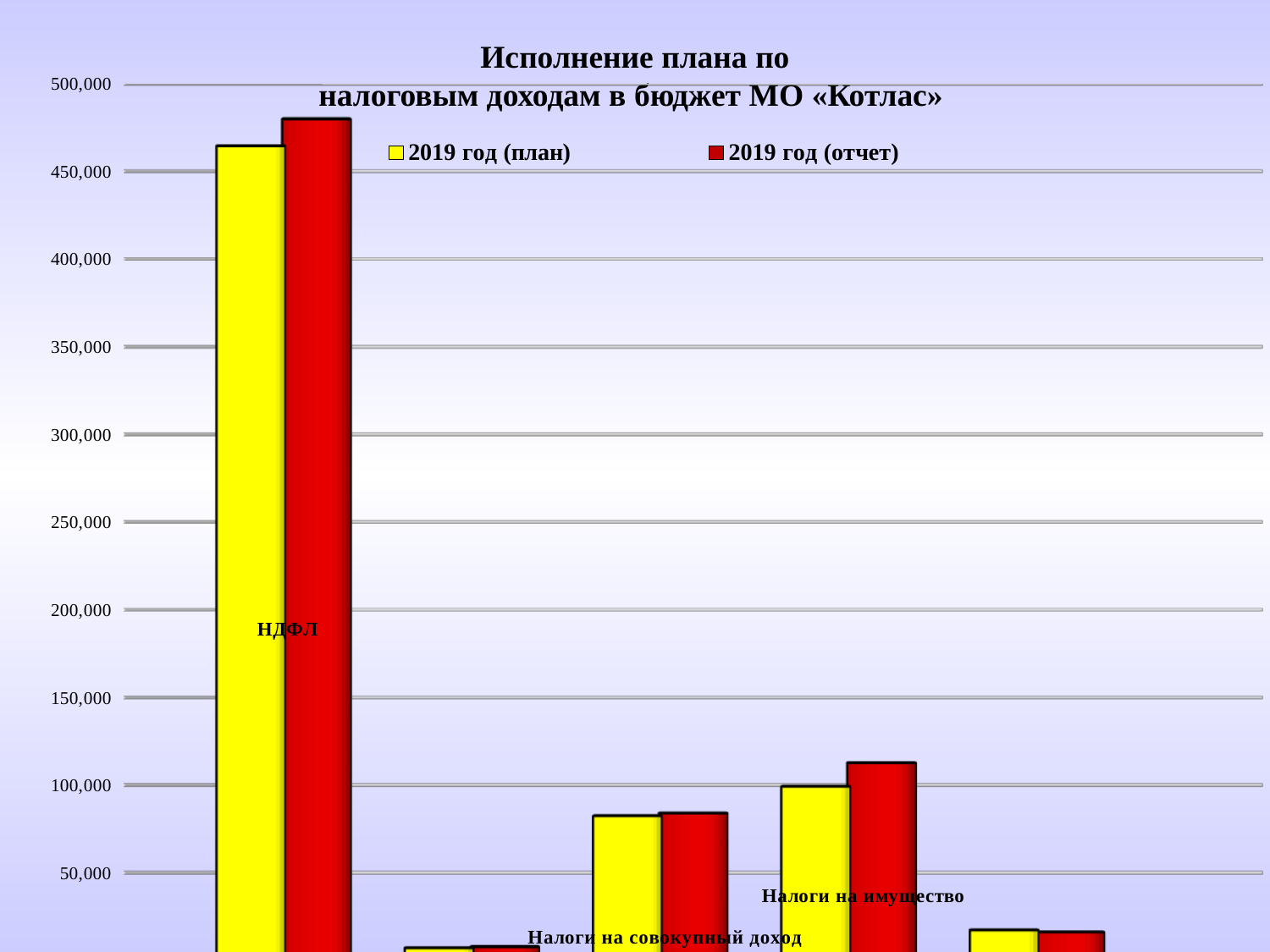
Which category has the highest values in the chart? НДФЛ What kind of chart is shown on the slide? bar chart Is the 2019 год (отчет) value for Налоги на совокупный доход greater or less than 50,000? greater How many series does the legend list? 2 Is the 2019 год (план) value for Налоги на совокупный доход greater or less than 100,000? less For Налоги на имущество, which is larger: the 2019 год (план) value or the 2019 год (отчет) value? 2019 год (отчет) For НДФЛ, which is larger: the 2019 год (план) value or the 2019 год (отчет) value? 2019 год (отчет) Is the 2019 год (отчет) value for Налоги на имущество greater or less than 100,000? greater What is the title of the chart? Исполнение плана по налоговым доходам в бюджет МО «Котлас» What colour are the bars for the 2019 год (отчет) series? red